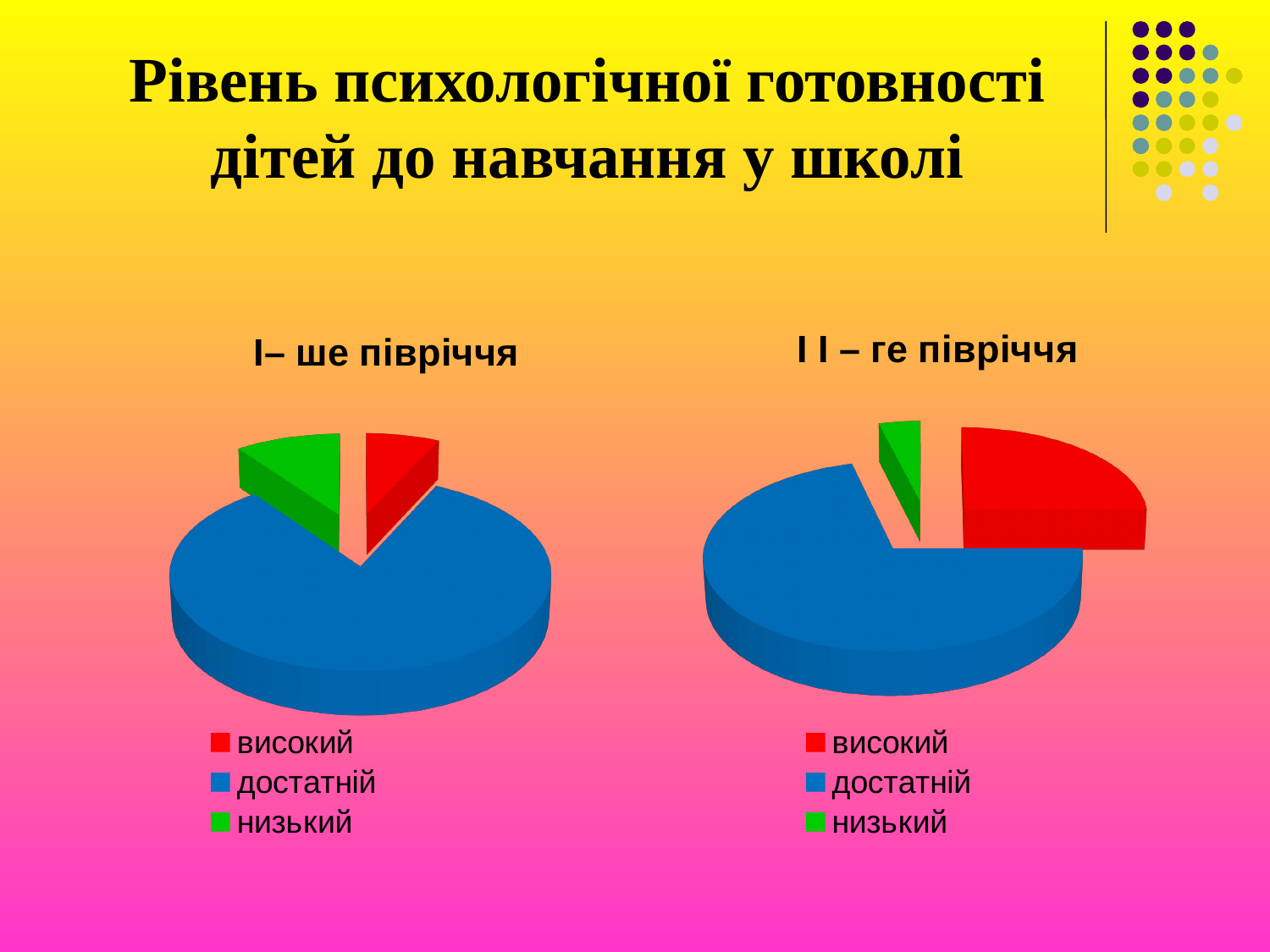
In the right chart ("І І – ге півріччя"), how many slices does the pie have? 3 In the left chart ("І– ше півріччя"), how many slices does the pie have? 3 What is the title of the chart on the right side of the slide? І І – ге півріччя In the left chart ("І– ше півріччя"), which category has the largest slice? достатній In the right chart ("І І – ге півріччя"), which category has the smallest slice? низький In the left chart ("І– ше півріччя"), which slice is larger: достатній or високий? достатній What kind of chart is the right chart titled "І І – ге півріччя"? pie chart How many entries does the legend of the left chart ("І– ше півріччя") list? 3 In the right chart ("І І – ге півріччя"), which slice is larger: високий or низький? високий In the right chart ("І І – ге півріччя"), which category has the largest slice? достатній What kind of chart is the left chart titled "І– ше півріччя"? pie chart Which colour represents the category "низький" in the charts? green